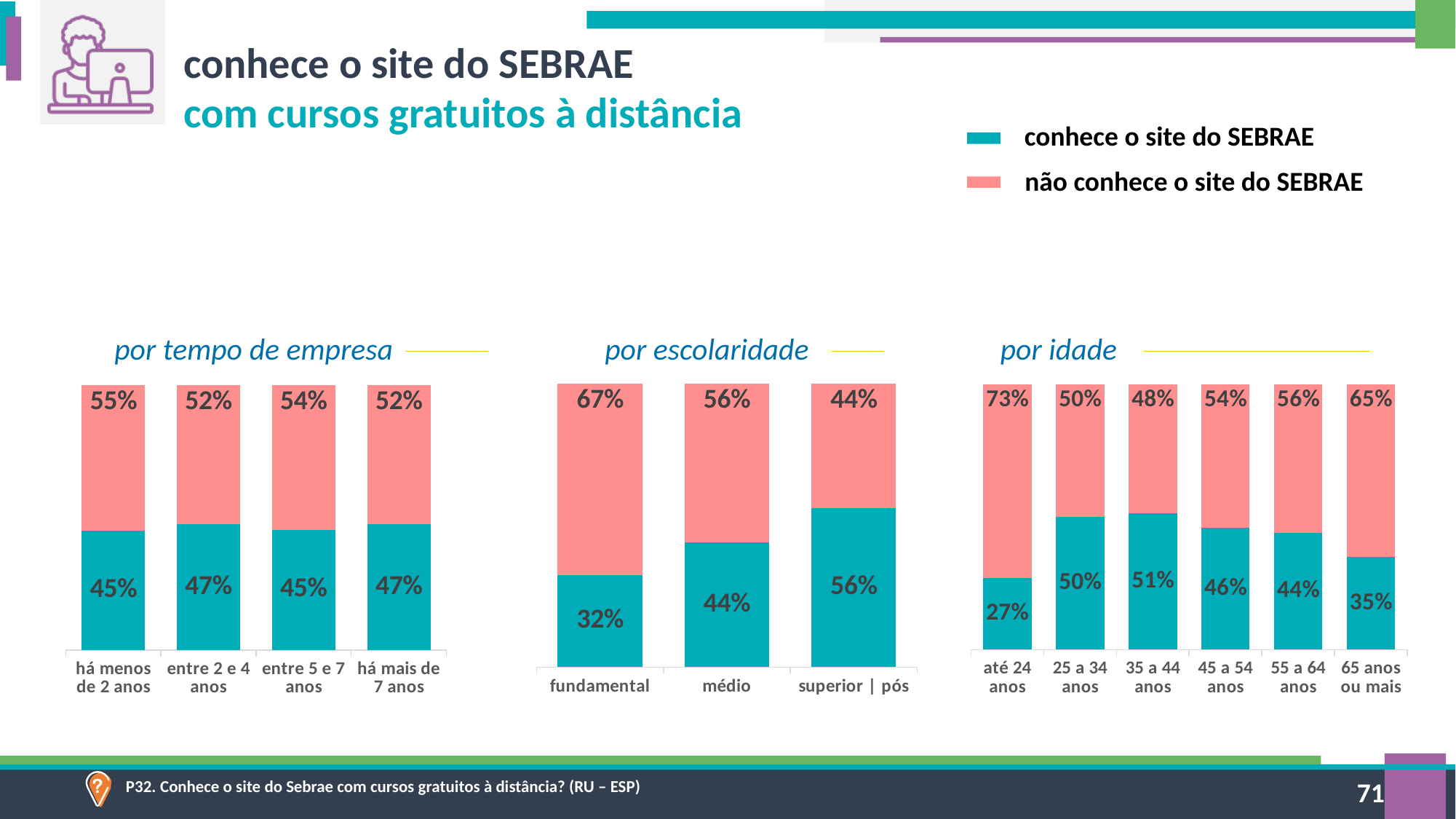
In the 'por idade' chart, what percentage of 'até 24 anos' conhece o site do SEBRAE? 27% How many series does the legend list? 2 How many categories are shown in the 'por idade' chart? 6 In the 'por escolaridade' chart, which is larger: the 'conhece' value for 'médio' or for 'fundamental'? médio In the 'por escolaridade' chart, what percentage of 'fundamental' não conhece o site do SEBRAE? 67% In the 'por tempo de empresa' chart, what percentage of 'entre 2 e 4 anos' conhece o site do SEBRAE? 47% In the 'por idade' chart, which age group has the lowest share that conhece o site do SEBRAE? até 24 anos In the 'por escolaridade' chart, what is the total of the stacked bar for 'médio'? 100% How many categories are shown in the 'por tempo de empresa' chart? 4 What kind of chart is the 'por escolaridade' chart? stacked bar chart In the 'por escolaridade' chart, which category has the highest share that conhece o site do SEBRAE? superior | pós In the 'por idade' chart, what is the difference between the 'não conhece' values for '65 anos ou mais' and '35 a 44 anos'? 17%